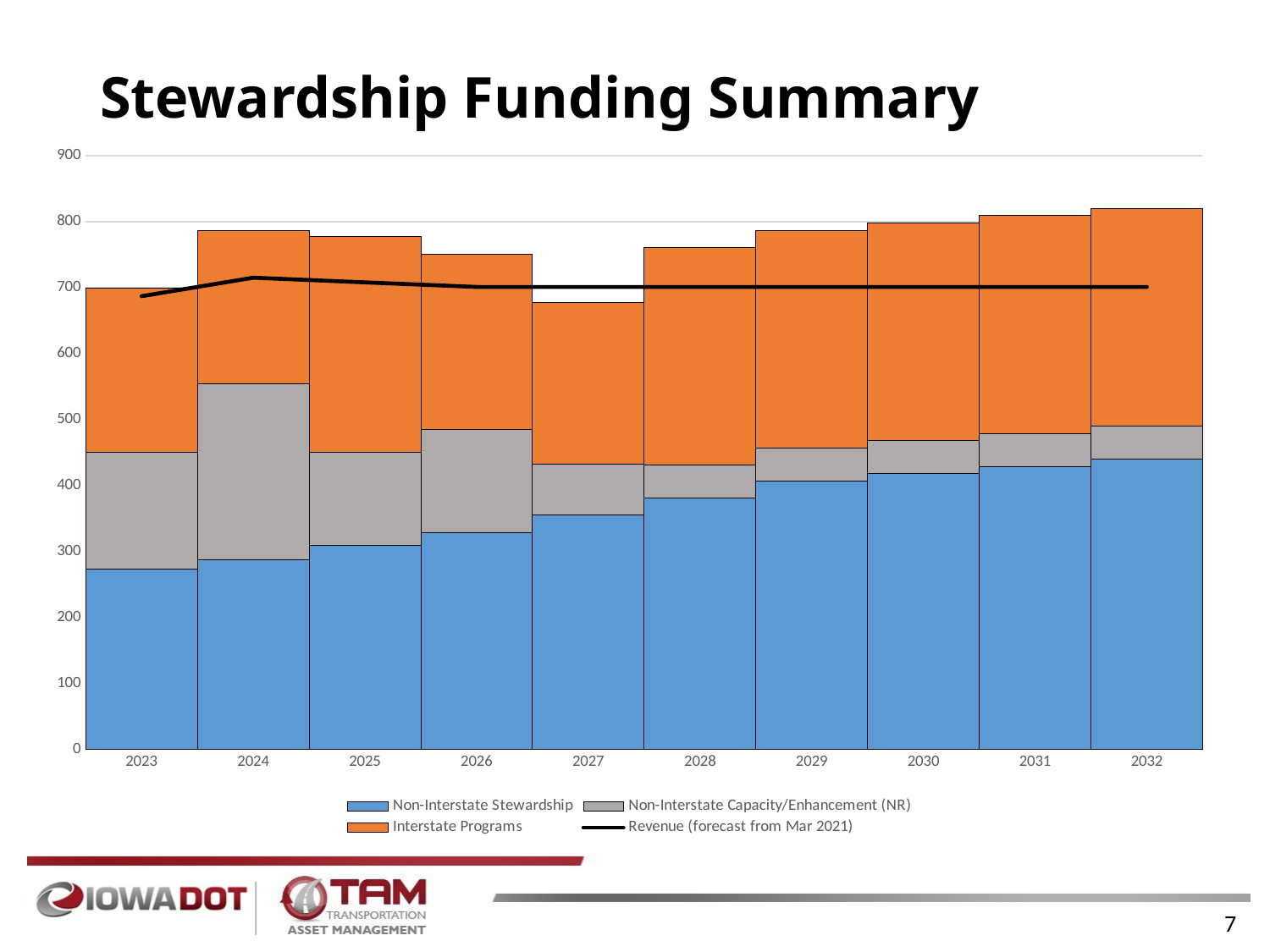
Which year has the highest total stacked bar? 2032 Is the total stacked bar larger in 2023 or 2024? 2024 What kind of chart is shown on the slide? Stacked bar chart with a line How many years are shown on the x axis of the chart? 10 How many series does the legend list? 4 Is the total stacked bar for 2032 greater or less than 800? greater Is the total stacked bar for 2027 greater or less than 700? less Does the Non-Interstate Stewardship series rise or fall from 2023 to 2032? rise What is the title of the chart on the slide? Stewardship Funding Summary Is the Non-Interstate Stewardship value for 2023 greater or less than 300? less Which series is drawn as a black line? Revenue (forecast from Mar 2021) Which year has the lowest total stacked bar? 2027